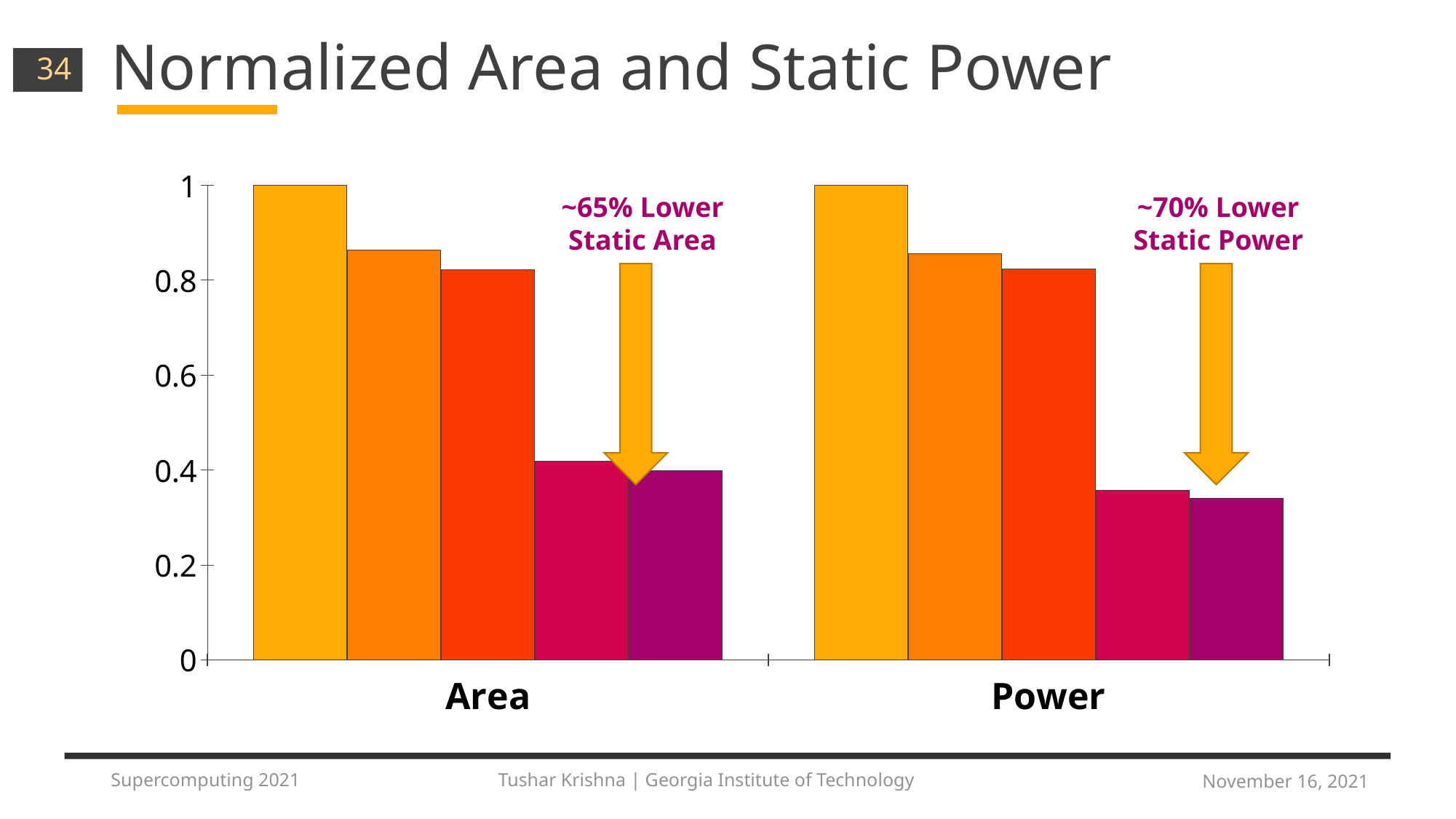
Is the value of the second (orange) bar in the Power category greater or less than 0.8? greater What is the value of the first (yellow) bar in the Area category? 1 How many categories are shown on the x axis of the chart? 2 Is the value of the last (purple) bar in the Power category greater or less than 0.4? less What reduction in static power does the annotation above the Power bars state? ~70% Lower Static Power Within the Power category, which bar is the shortest? the last (purple) bar How many bars are plotted for the Area category? 5 What kind of chart is shown on the slide? bar chart What is the value of the first (yellow) bar in the Power category? 1 Is the value of the last (purple) bar in the Area category greater or less than 0.6? less Do the bar heights rise or fall from left to right within each category? fall Within the Area category, which bar is the tallest? the first (yellow) bar